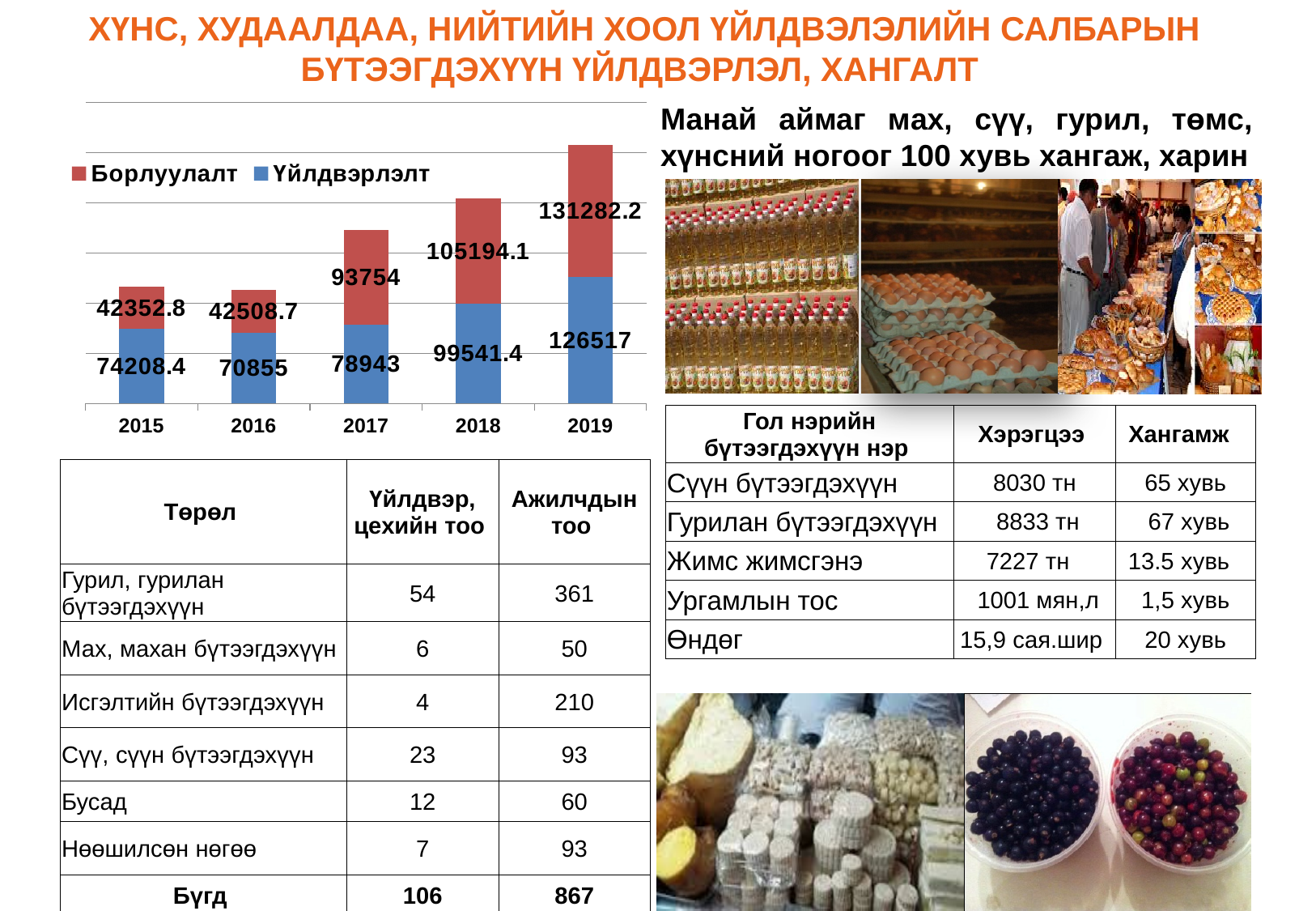
What is the Борлуулалт value for 2017? 93754 What is the total of the stacked bar for 2019? 257799.2 What is the difference between the Борлуулалт values for 2019 and 2015? 88929.4 How many series does the chart legend list? 2 Which is larger in 2018, Борлуулалт or Үйлдвэрлэлт? Борлуулалт Which year has the lowest Үйлдвэрлэлт value? 2016 Which year has the highest Борлуулалт value? 2019 What kind of chart is shown on the slide? Stacked bar chart What is the Үйлдвэрлэлт value for 2016? 70855 What is the Борлуулалт value for 2019? 131282.2 Do the total stacked bar heights generally rise or fall from 2016 to 2019? Rise How many years are shown on the x axis of the chart? 5